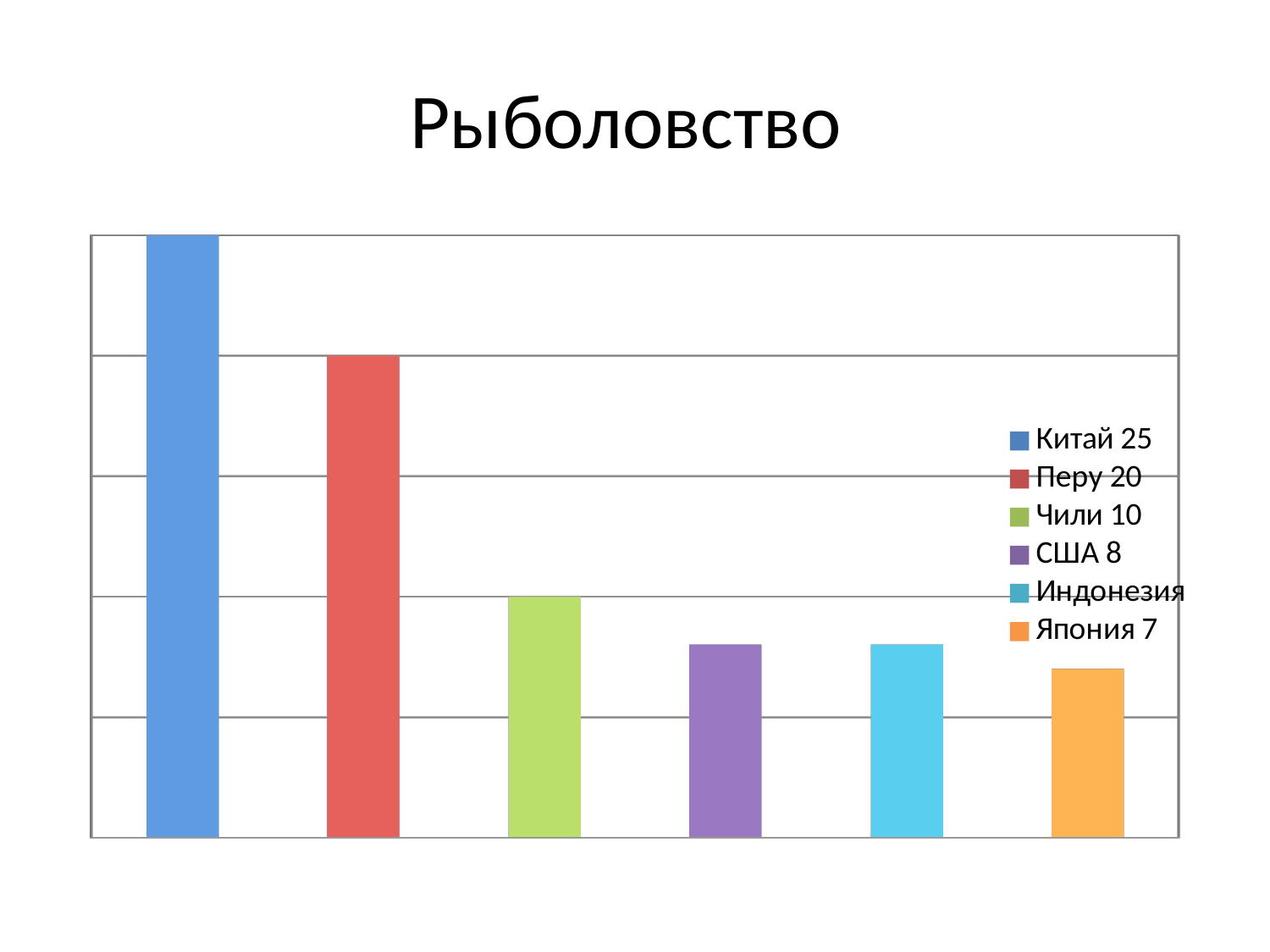
Which country has the shortest bar? Япония What value is shown for Перу in the legend? 20 How many entries does the legend list? 6 Which country has the tallest bar? Китай What is the difference between the values for Китай and Перу? 5 What value is shown for Чили in the legend? 10 Which is larger, the value for Перу or the value for Чили? Перу How many bars are plotted in the chart? 6 What value is shown for США in the legend? 8 What value is shown for Китай in the legend? 25 What value is shown for Япония in the legend? 7 What type of chart is shown on the slide? Bar chart